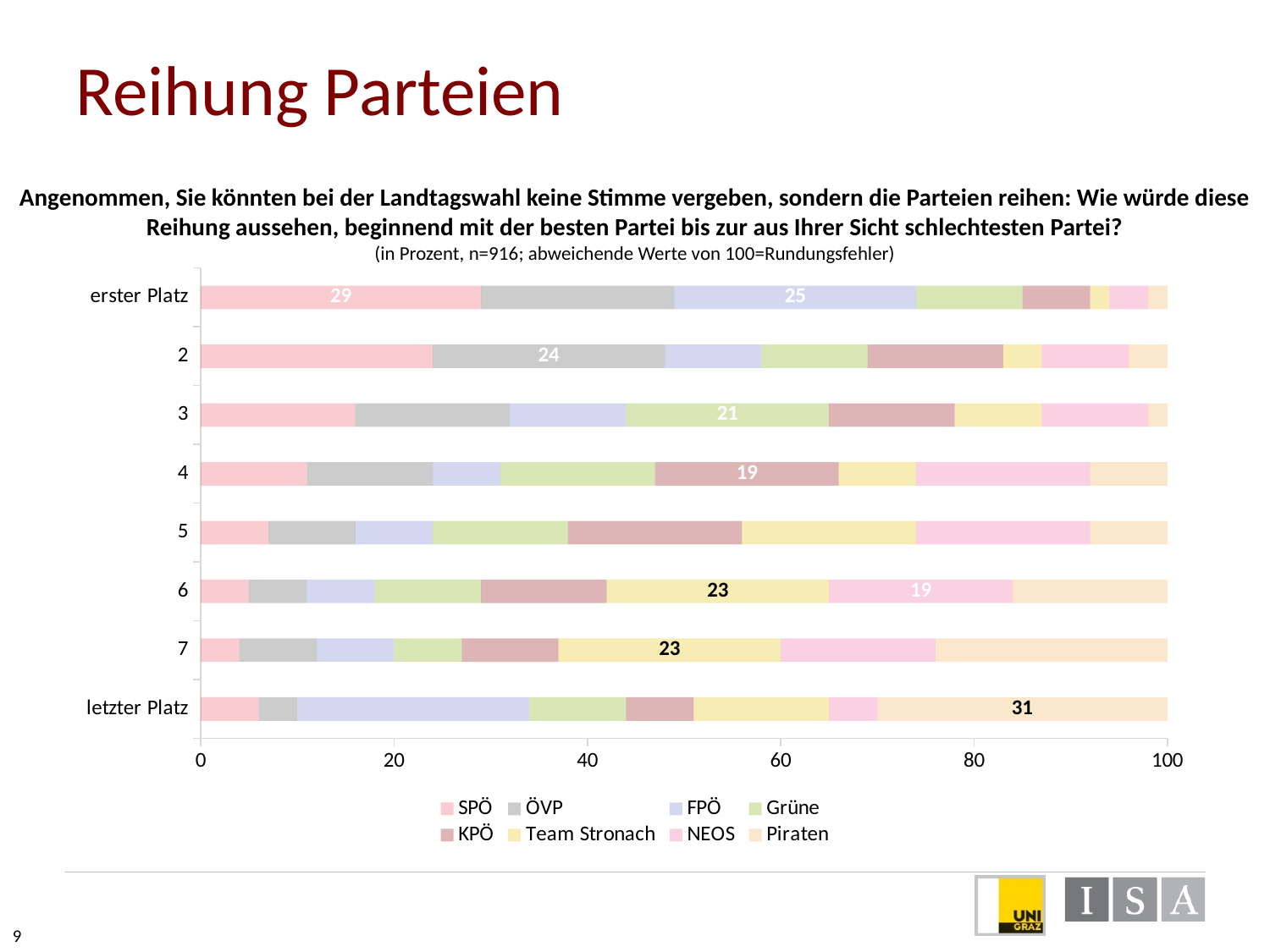
What is the value for KPÖ at position 4? 19 What is the value for Grüne at position 3? 21 What is the value for Piraten at 'letzter Platz'? 31 Which series is listed first in the legend? SPÖ How many ranking positions (categories) are shown on the vertical axis? 8 At 'erster Platz', which is larger: the SPÖ value or the FPÖ value? SPÖ How many series does the legend list? 8 What is the value for FPÖ at 'erster Platz'? 25 What is the value for SPÖ at 'erster Platz'? 29 What type of chart is shown on the slide? stacked bar chart What is the value for ÖVP at position 2? 24 At 'erster Platz', what is the difference between the SPÖ value and the FPÖ value? 4